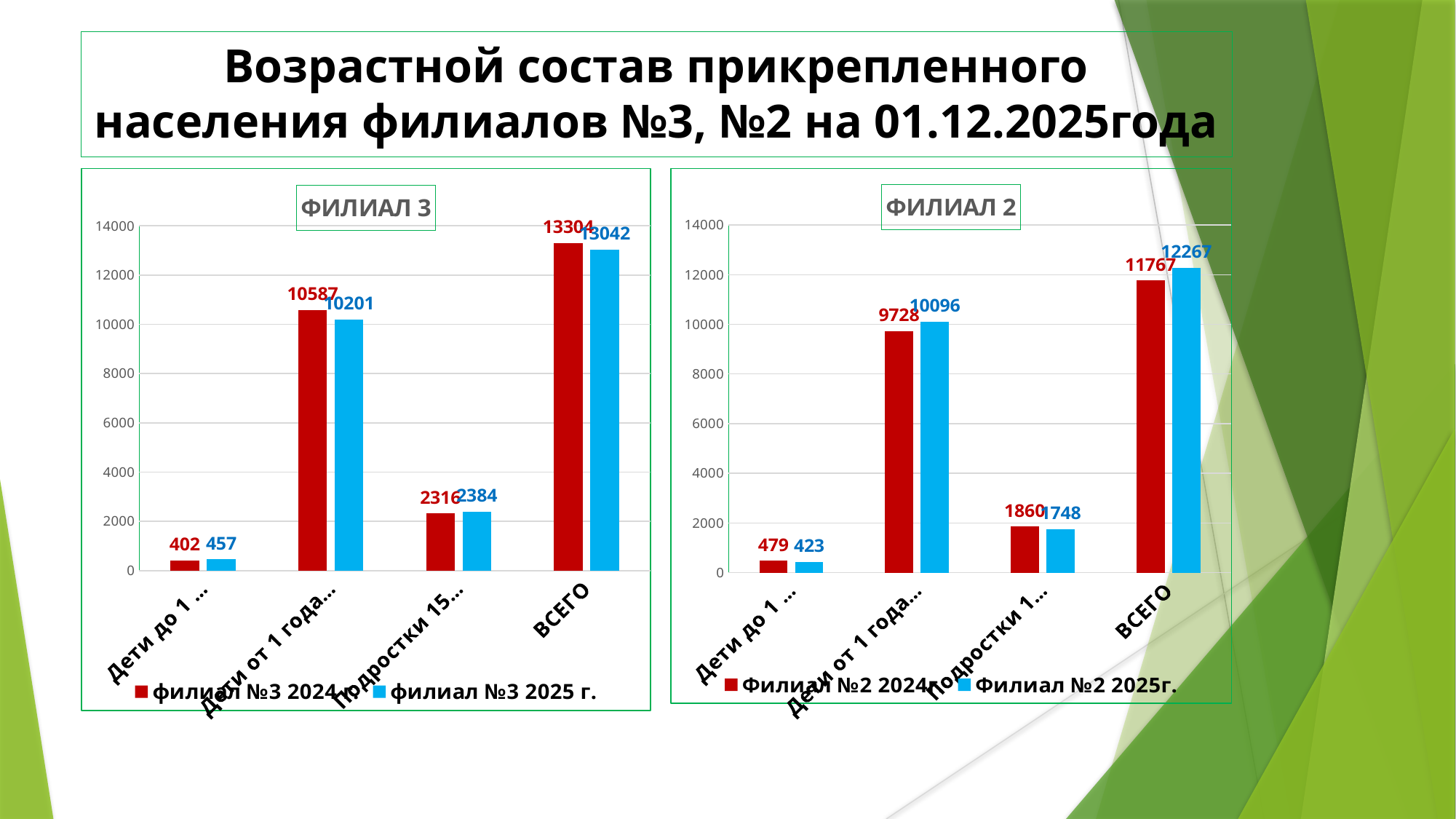
What kind of chart is the ФИЛИАЛ 2 chart? Bar chart In the ФИЛИАЛ 3 chart, what is the value for ВСЕГО in the series филиал №3 2025 г.? 13042 In the ФИЛИАЛ 2 chart, what is the value for ВСЕГО in the series Филиал №2 2024г.? 11767 How many categories are shown on the x axis of the ФИЛИАЛ 2 chart? 4 In the ФИЛИАЛ 2 chart, what is the difference between the ВСЕГО values for 2025 and 2024? 500 In the ФИЛИАЛ 2 chart, what is the value for ВСЕГО in the series Филиал №2 2025г.? 12267 In the ФИЛИАЛ 2 chart, which is larger for ВСЕГО: the 2024 value or the 2025 value? 2025 (12267) In the ФИЛИАЛ 3 chart, what is the difference between the ВСЕГО values for 2024 and 2025? 262 In the ФИЛИАЛ 3 chart, what is the value for ВСЕГО in the series филиал №3 2024 г.? 13304 How many series does the legend of the ФИЛИАЛ 3 chart list? 2 In the ФИЛИАЛ 3 chart, which category has the lowest values? Дети до 1 ... In the ФИЛИАЛ 3 chart, is the 2025 value for ВСЕГО greater or less than 12000? greater